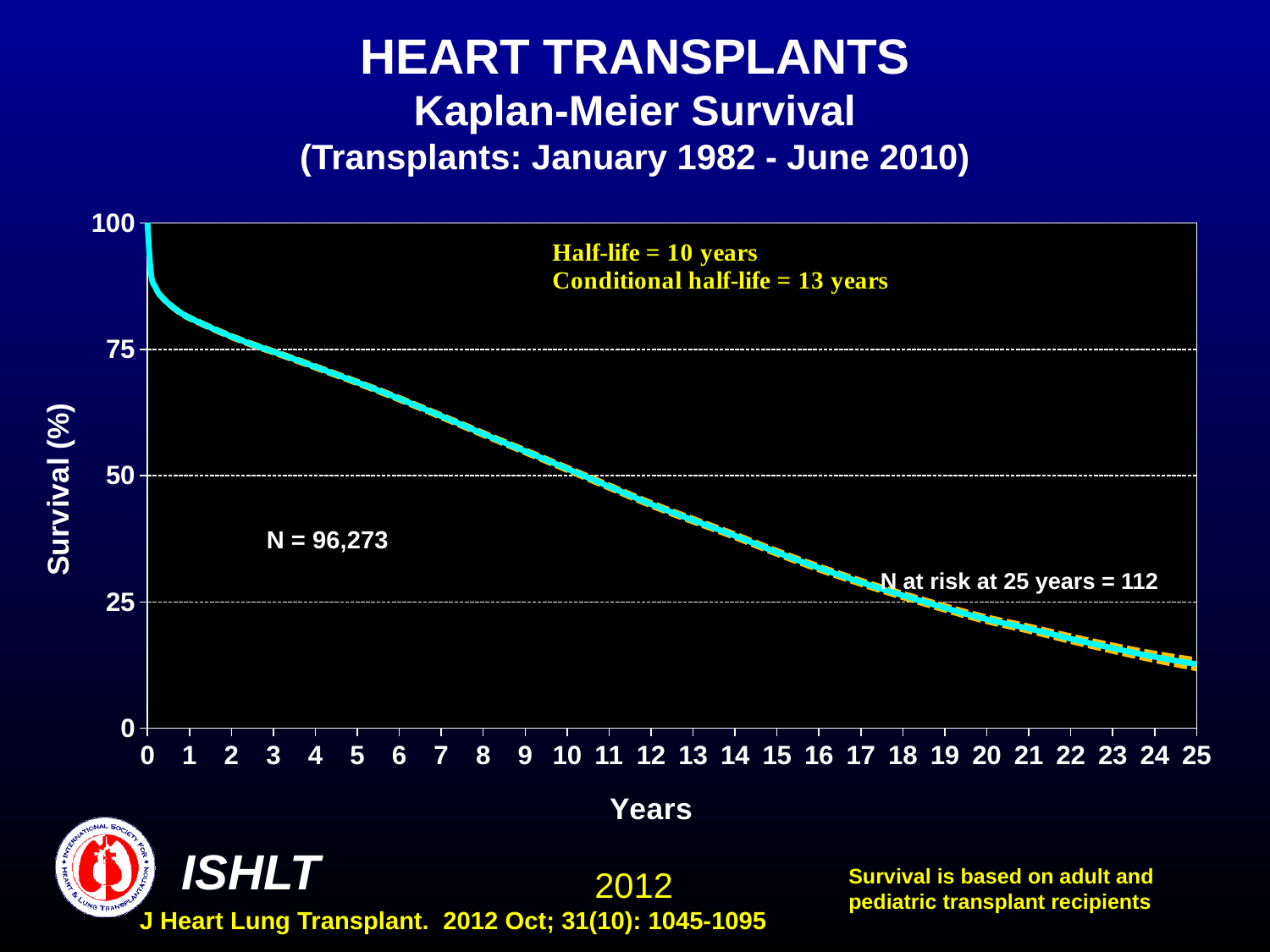
What is the label of the y axis? Survival (%) What is the label of the x axis? Years What is the conditional half-life stated on the chart? 13 years What is the value of N shown on the chart? 96,273 Is the survival value at 25 years greater or less than 25? less Is the survival value at 15 years greater or less than 25? greater Is the survival value at 5 years greater or less than 75? less What kind of chart is shown on the slide? line chart What is the N at risk at 25 years? 112 What is the half-life stated on the chart? 10 years Does survival rise or fall as years since transplant increase? fall